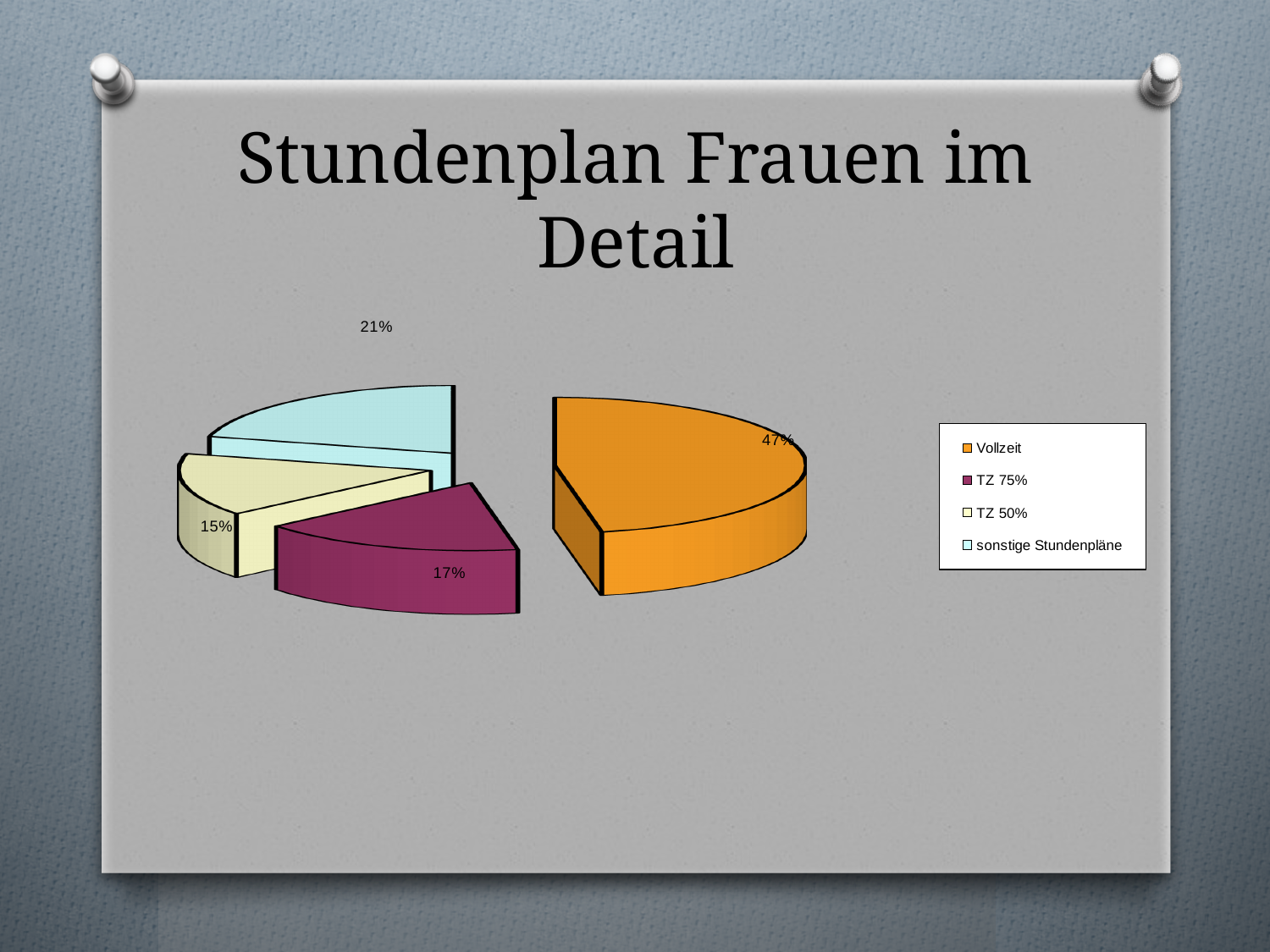
Which slice is larger, TZ 75% or TZ 50%? TZ 75% What share of the pie does Vollzeit have? 47% What is the difference in percentage points between the Vollzeit slice and the sonstige Stundenpläne slice? 26 What share of the pie does TZ 75% have? 17% How many slices does the pie chart have? 4 Which category has the smallest slice of the pie? TZ 50% How many entries does the legend list? 4 What colour is the Vollzeit slice in the pie chart? orange What share of the pie does TZ 50% have? 15% Which category has the largest slice of the pie? Vollzeit What kind of chart is shown on the slide? pie chart